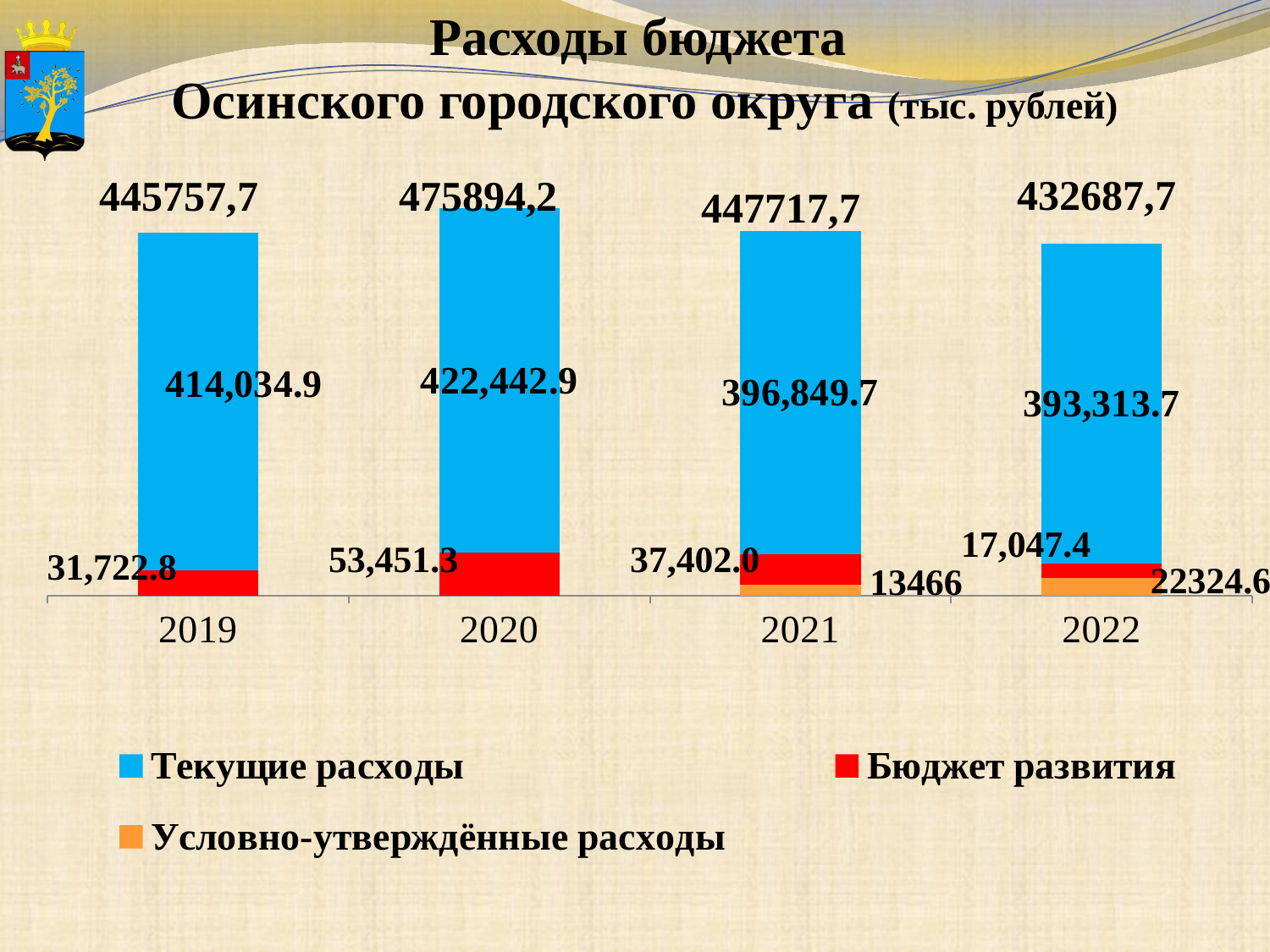
Which year has the lowest value of Бюджет развития? 2022 What is the value of Условно-утверждённые расходы for 2022? 22324.6 Which is larger: Бюджет развития in 2020 or in 2021? 2020 What type of chart is shown on the slide? Stacked bar chart What is the total printed above the bar for 2021? 447717,7 How many series does the legend list? 3 What is the difference between Условно-утверждённые расходы in 2022 and in 2021? 8858.6 How many years are shown on the x axis? 4 What is the value of Текущие расходы for 2020? 422,442.9 What is the value of Бюджет развития for 2019? 31,722.8 Which year has the highest value of Текущие расходы? 2020 Which colour represents Бюджет развития in the legend? Red